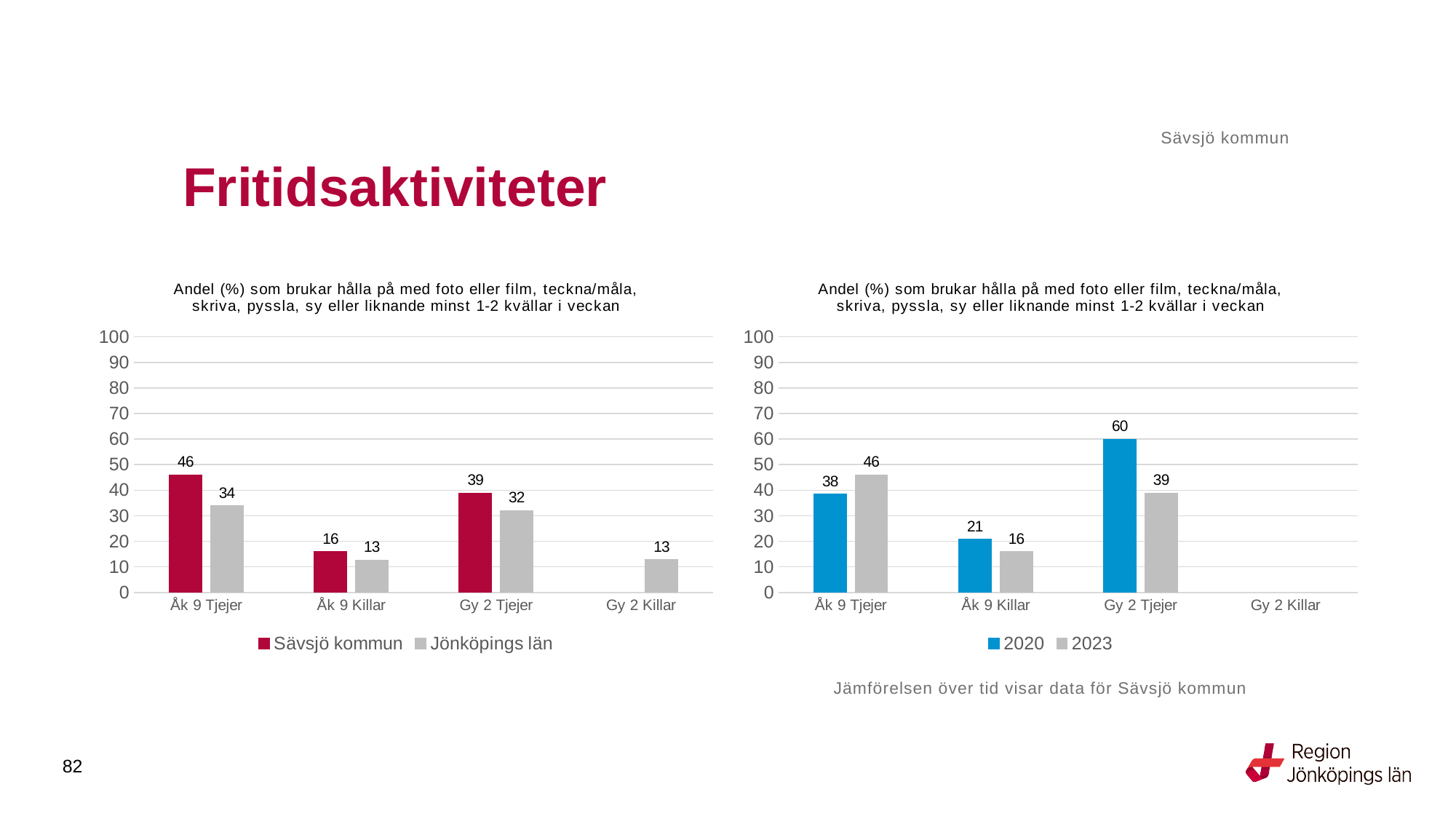
In the left chart, what is the value for Jönköpings län for Gy 2 Killar? 13 In the left chart, what is the difference between Sävsjö kommun and Jönköpings län for Gy 2 Tjejer? 7 In the left chart, what is the value for Sävsjö kommun for Åk 9 Tjejer? 46 In the left chart, which is larger for Åk 9 Killar: Sävsjö kommun or Jönköpings län? Sävsjö kommun In the right chart, which is larger for Åk 9 Tjejer: 2020 or 2023? 2023 How many series does the legend of the left chart list? 2 In the right chart, what is the difference between 2020 and 2023 for Gy 2 Tjejer? 21 In the right chart, what is the value for 2020 for Gy 2 Tjejer? 60 In the right chart, what is the value for 2023 for Åk 9 Killar? 16 What type of chart is the right chart? Bar chart In the right chart, which category has the lowest value for 2023 among those with a bar shown? Åk 9 Killar In the left chart, which category has the highest value for Jönköpings län? Åk 9 Tjejer